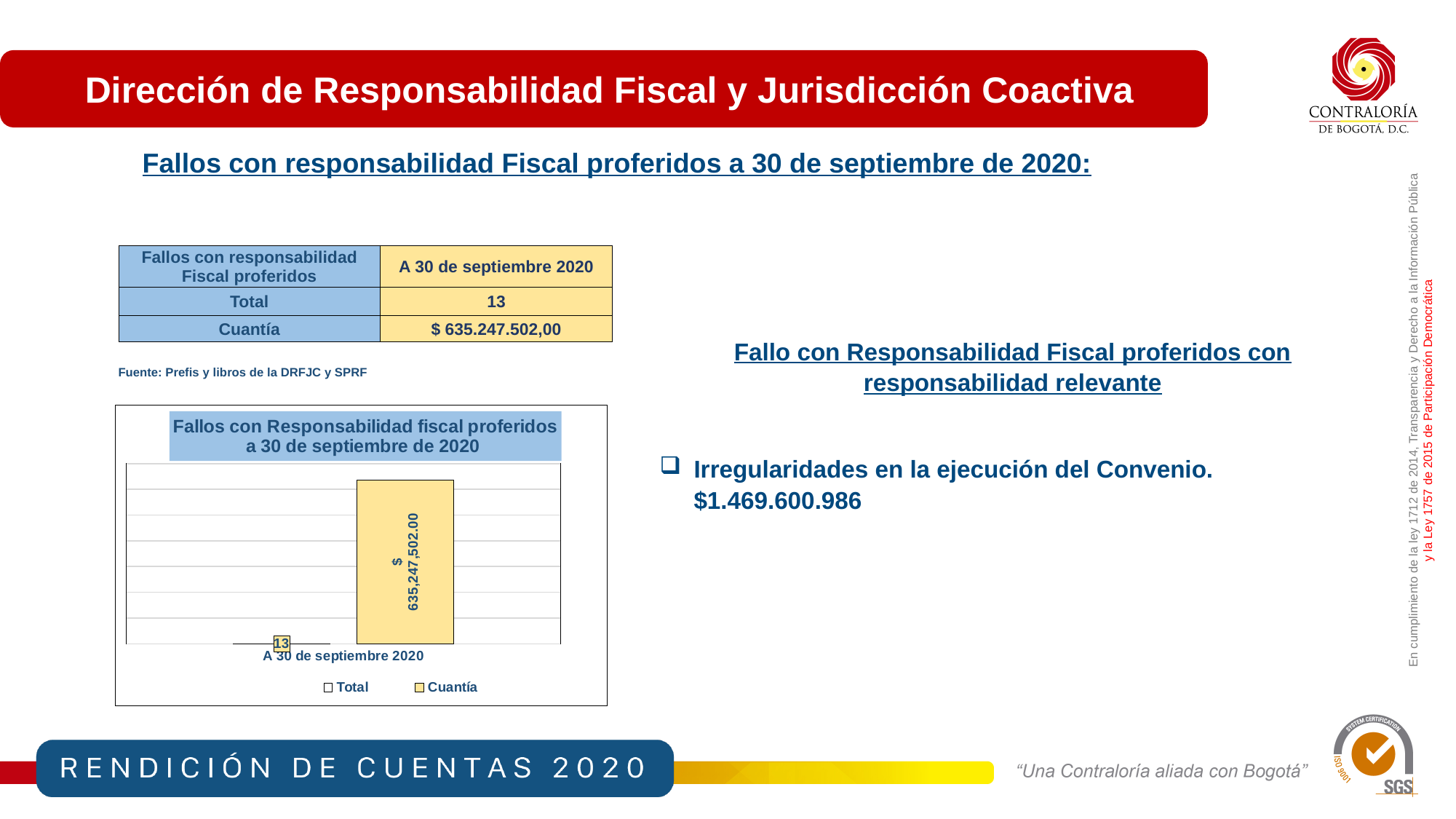
What kind of chart is shown on the slide? bar chart What is the value of the Cuantía series in the chart? $ 635,247,502.00 What are the series names listed in the chart's legend? Total, Cuantía How many series does the chart's legend list? 2 What is the category label on the x axis of the chart? A 30 de septiembre 2020 What is the title of the chart on the slide? Fallos con Responsabilidad fiscal proferidos a 30 de septiembre de 2020 How many categories are shown on the x axis of the chart? 1 Which series has the highest value in the chart? Cuantía Which series has the lowest value in the chart? Total Which series has the taller bar in the chart, Total or Cuantía? Cuantía What is the value of the Total series in the chart? 13